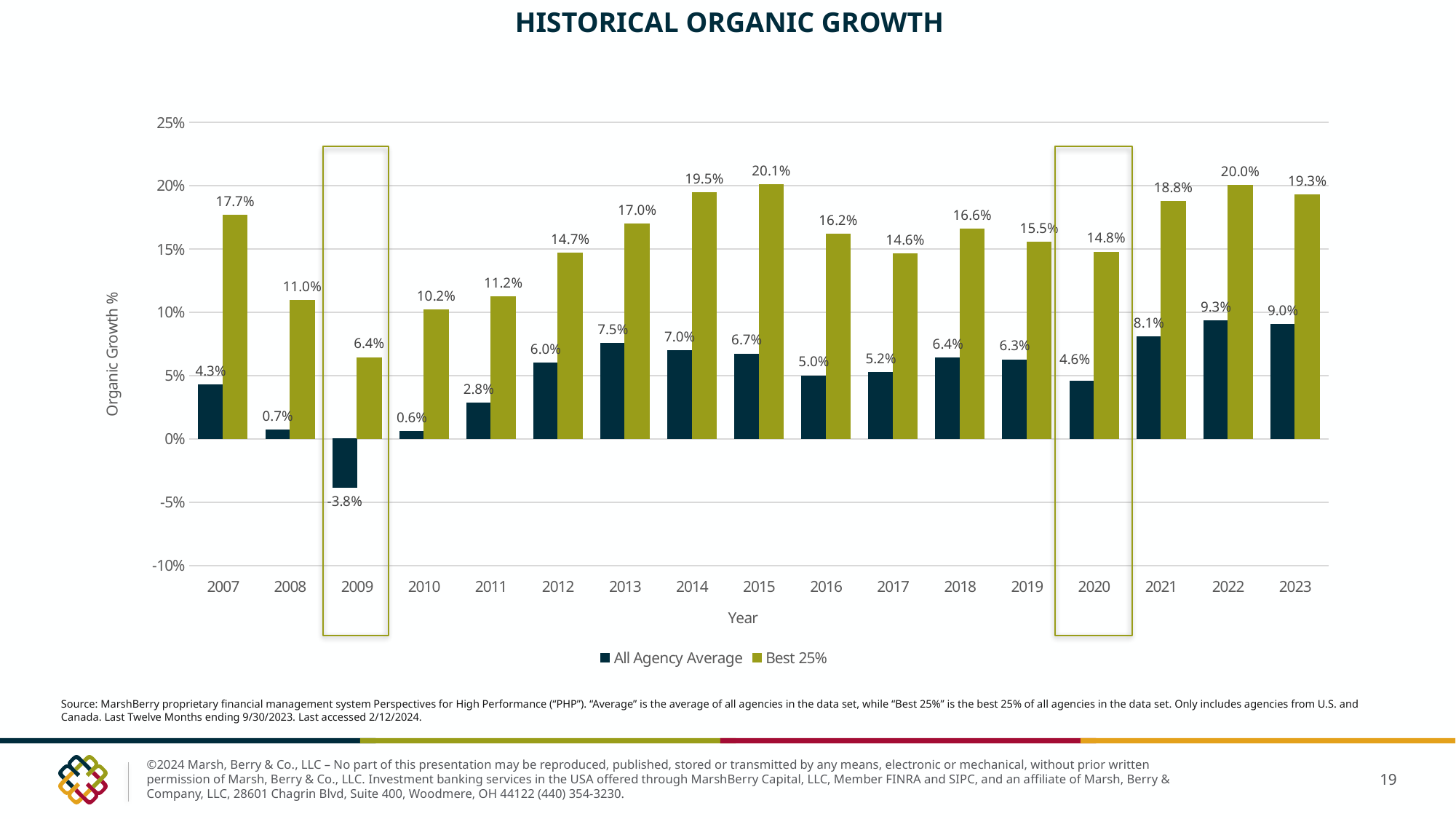
Is the Best 25% organic growth for 2014 greater or less than 15%? greater What kind of chart is shown on the slide? Bar chart What is the title of the chart? HISTORICAL ORGANIC GROWTH What is the All Agency Average organic growth for 2022? 9.3% Which is larger, the All Agency Average organic growth in 2021 or in 2020? 2021 Which year has the lowest All Agency Average organic growth? 2009 What is the All Agency Average organic growth for 2009? -3.8% How many years are shown on the x axis? 17 What is the difference between the Best 25% and All Agency Average organic growth in 2023? 10.3% Which year has the highest Best 25% organic growth? 2015 How many series does the legend list? 2 What is the Best 25% organic growth for 2015? 20.1%